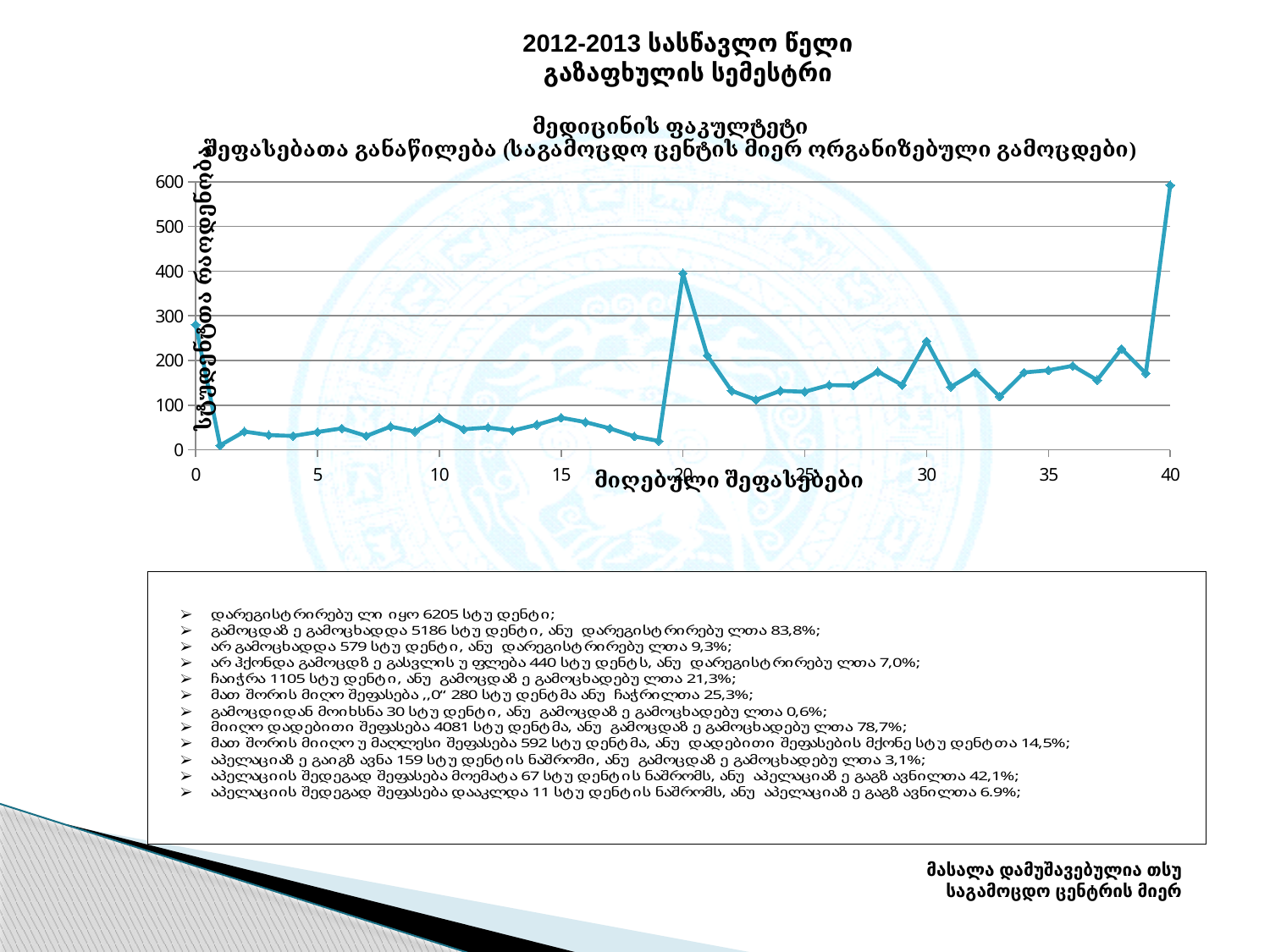
Is the value at x = 10 greater or less than 100? less Is the value at x = 40 greater or less than 500? greater Which is larger, the value at x = 20 or the value at x = 30? x = 20 What is the highest tick value shown on the y axis? 600 At which x-axis value does the line reach its highest point? 40 Is the value at x = 30 greater or less than 200? greater What is the label of the x axis of the chart? მიღებული შეფასებები What is the title of the chart? შეფასებათა განაწილება (საგამოცდო ცენტრის მიერ ორგანიზებული გამოცდები) What kind of chart is shown on the slide? line chart Which is larger, the value at x = 5 or the value at x = 35? x = 35